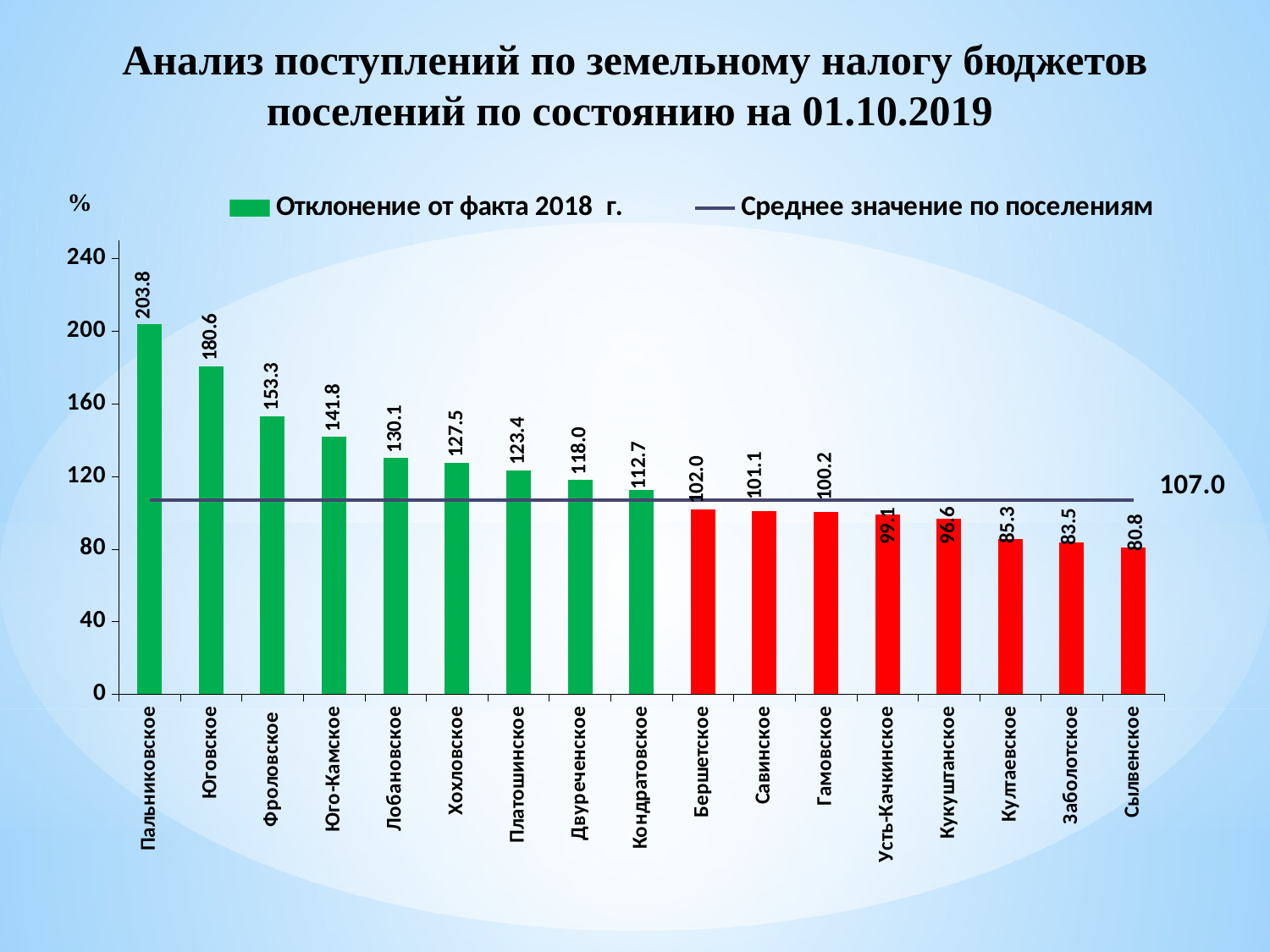
What is the value for Хохловское? 127.5 What is the value for Кукуштанское? 96.6 Which is larger, the value for Лобановское or the value for Платошинское? Лобановское How many settlements are shown on the x axis? 17 What is the value of the average line labelled 'Среднее значение по поселениям'? 107.0 What is the value for Пальниковское? 203.8 Which settlement has the highest value? Пальниковское Which settlement has the lowest value? Сылвенское What kind of chart is shown on the slide? bar chart Is the value for Култаевское greater or less than 120? less What is the difference between the values for Юговское and Фроловское? 27.3 How many entries does the legend list? 2